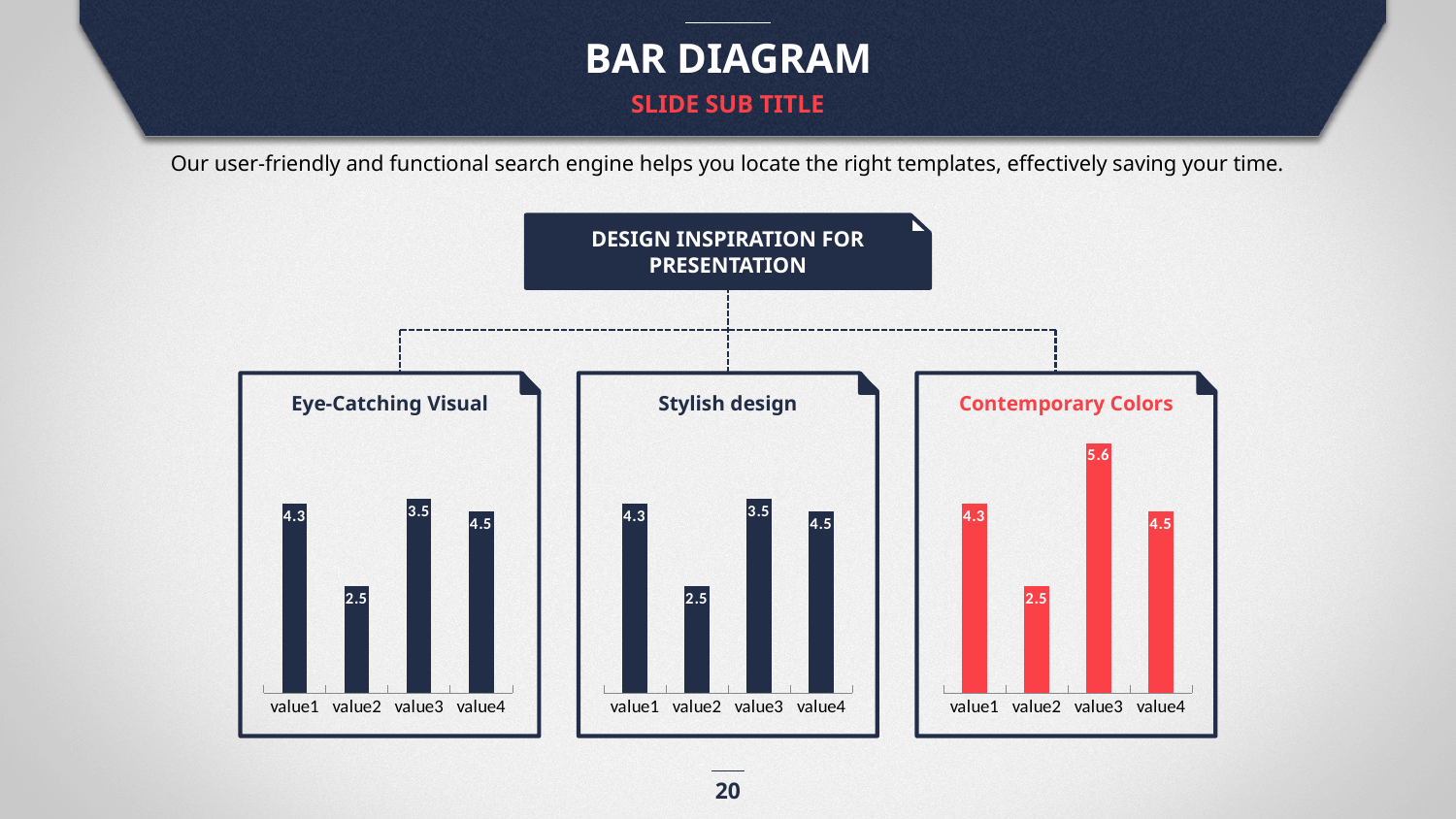
In the Eye-Catching Visual chart, what is the value for value2? 2.5 What kind of chart is the Stylish design chart? bar chart In the Contemporary Colors chart, what is the value for value3? 5.6 In the Contemporary Colors chart, what is the difference between value3 and value2? 3.1 In the Eye-Catching Visual chart, what is the difference between value1 and value3? 0.8 How many categories are shown in the Contemporary Colors chart? 4 What colour are the bars in the Contemporary Colors chart? red In the Contemporary Colors chart, which category has the highest value? value3 In the Stylish design chart, what is the value for value4? 4.5 In the Stylish design chart, which category has the highest value? value4 In the Stylish design chart, which is larger, value1 or value2? value1 In the Eye-Catching Visual chart, which category has the lowest value? value2